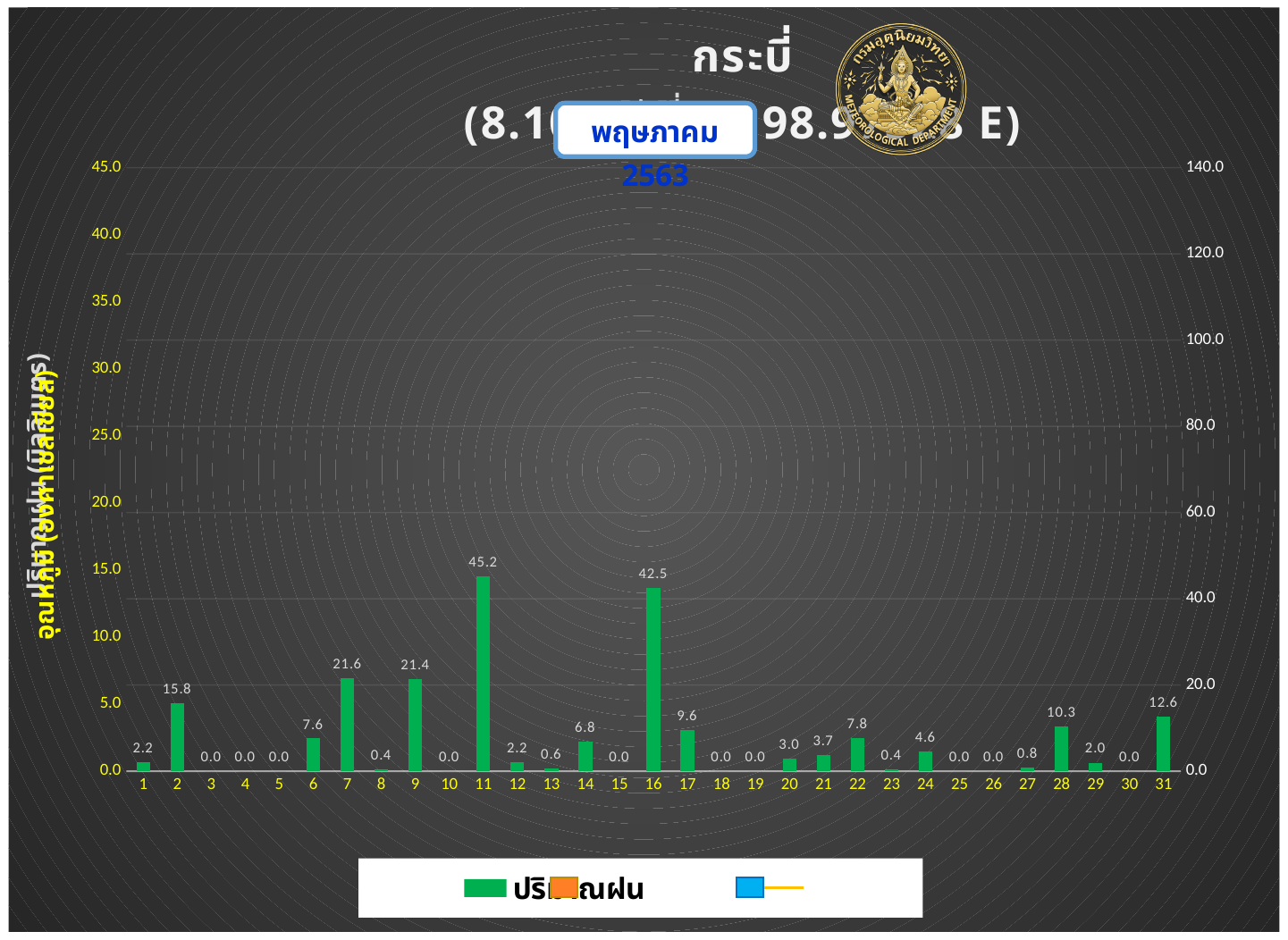
What is the rainfall value for day 31? 12.6 What is the difference between the rainfall values for day 11 and day 16? 2.7 Which day has the highest rainfall value? 11 Which is larger, the rainfall value for day 6 or for day 22? day 22 What year is shown below the month label on the chart? 2563 What is the difference between the rainfall values for day 7 and day 9? 0.2 What is the rainfall value for day 11? 45.2 What is the rainfall value for day 16? 42.5 Which is larger, the rainfall value for day 28 or for day 17? day 28 How many days (categories) are shown on the x axis? 31 What is the rainfall value for day 2? 15.8 What type of chart is shown on the slide? bar chart